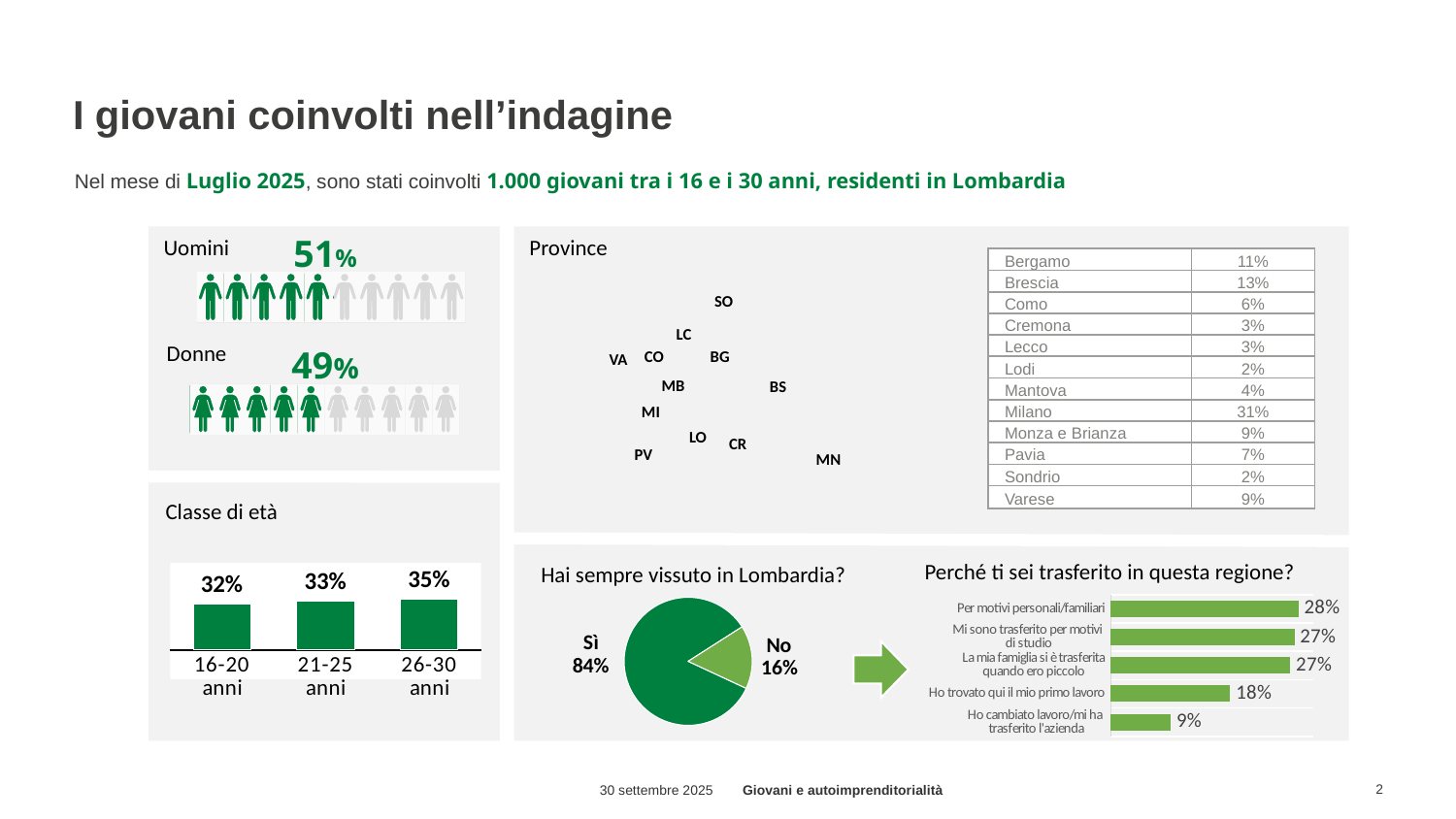
In the 'Perché ti sei trasferito in questa regione?' chart, what is the difference between 'Ho trovato qui il mio primo lavoro' and 'Ho cambiato lavoro/mi ha trasferito l'azienda'? 9% In the 'Perché ti sei trasferito in questa regione?' chart, which reason has the lowest value? Ho cambiato lavoro/mi ha trasferito l'azienda In the 'Classe di età' chart, what is the value for the 26-30 anni group? 35% What kind of chart is 'Hai sempre vissuto in Lombardia?'? pie chart In the 'Hai sempre vissuto in Lombardia?' pie chart, what share answered 'No'? 16% In the 'Classe di età' chart, do the values rise or fall from left to right along the x axis? rise In the 'Classe di età' chart, which age group has the lowest value? 16-20 anni In the 'Classe di età' chart, what is the difference between the 26-30 anni and 16-20 anni values? 3% In the 'Hai sempre vissuto in Lombardia?' pie chart, which slice is larger, 'Sì' or 'No'? Sì In the 'Classe di età' chart, how many age groups are shown? 3 In the 'Perché ti sei trasferito in questa regione?' chart, what is the value for 'Per motivi personali/familiari'? 28% What kind of chart is 'Perché ti sei trasferito in questa regione?'? bar chart